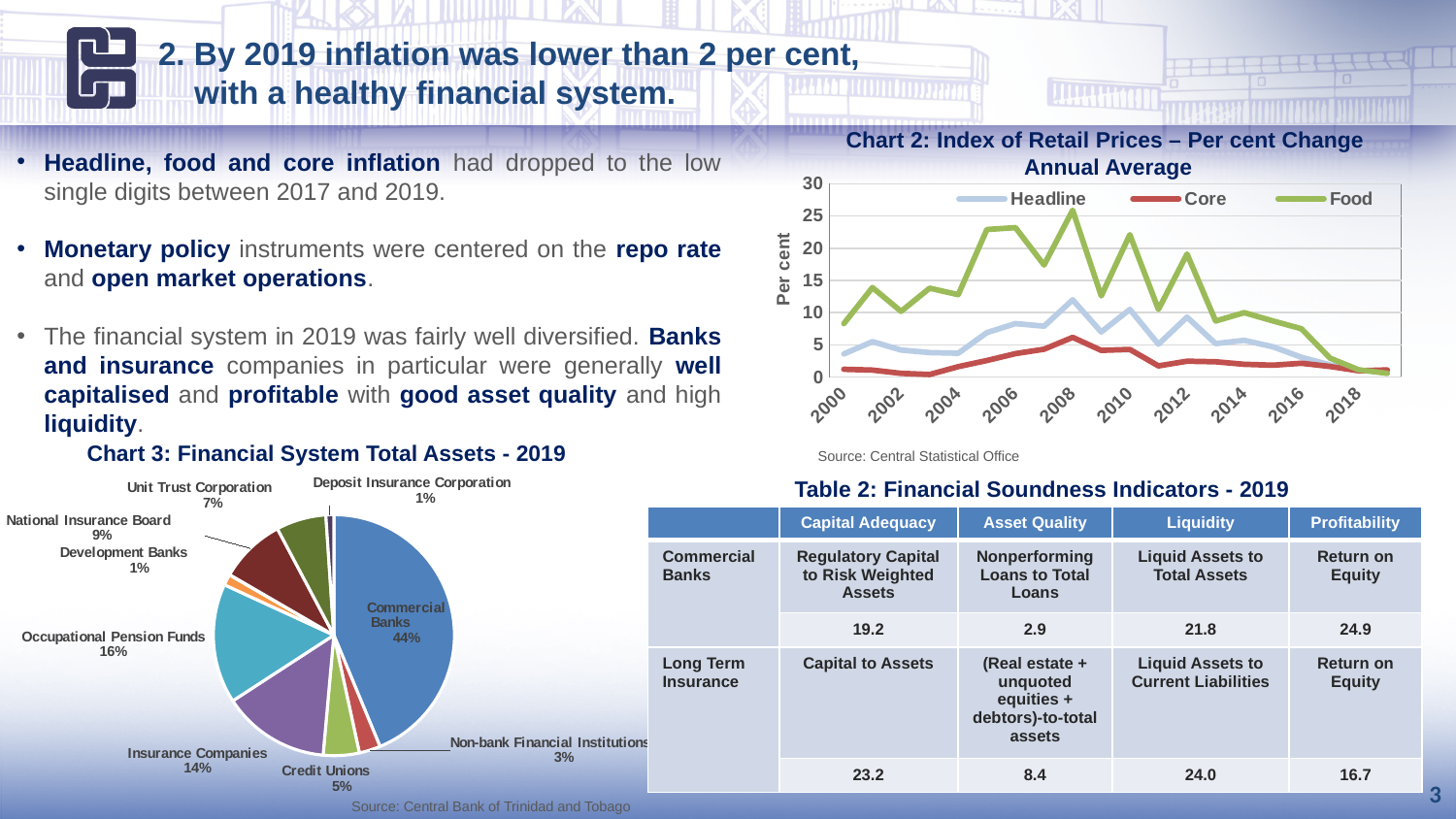
In Chart 3: Financial System Total Assets - 2019, what is the difference in percentage points between Insurance Companies and Credit Unions? 9 In Chart 3: Financial System Total Assets - 2019, what share of total assets do Commercial Banks hold? 44% In Chart 3: Financial System Total Assets - 2019, which is larger, the share of the National Insurance Board or the Unit Trust Corporation? National Insurance Board What type of chart is Chart 3: Financial System Total Assets - 2019? Pie chart In Chart 3: Financial System Total Assets - 2019, what is the share for Occupational Pension Funds? 16% In Chart 3: Financial System Total Assets - 2019, how many categories are shown in the pie? 9 In Chart 2: Index of Retail Prices, is the value for Food in 2008 greater or less than 20? greater In Chart 2: Index of Retail Prices, which series has the highest value in 2008? Food How many series does the legend of Chart 2: Index of Retail Prices list? 3 What type of chart is Chart 2: Index of Retail Prices – Per cent Change Annual Average? Line chart In Chart 2: Index of Retail Prices, is the value for Core in 2018 greater or less than 5? less In Chart 3: Financial System Total Assets - 2019, which category has the largest share? Commercial Banks